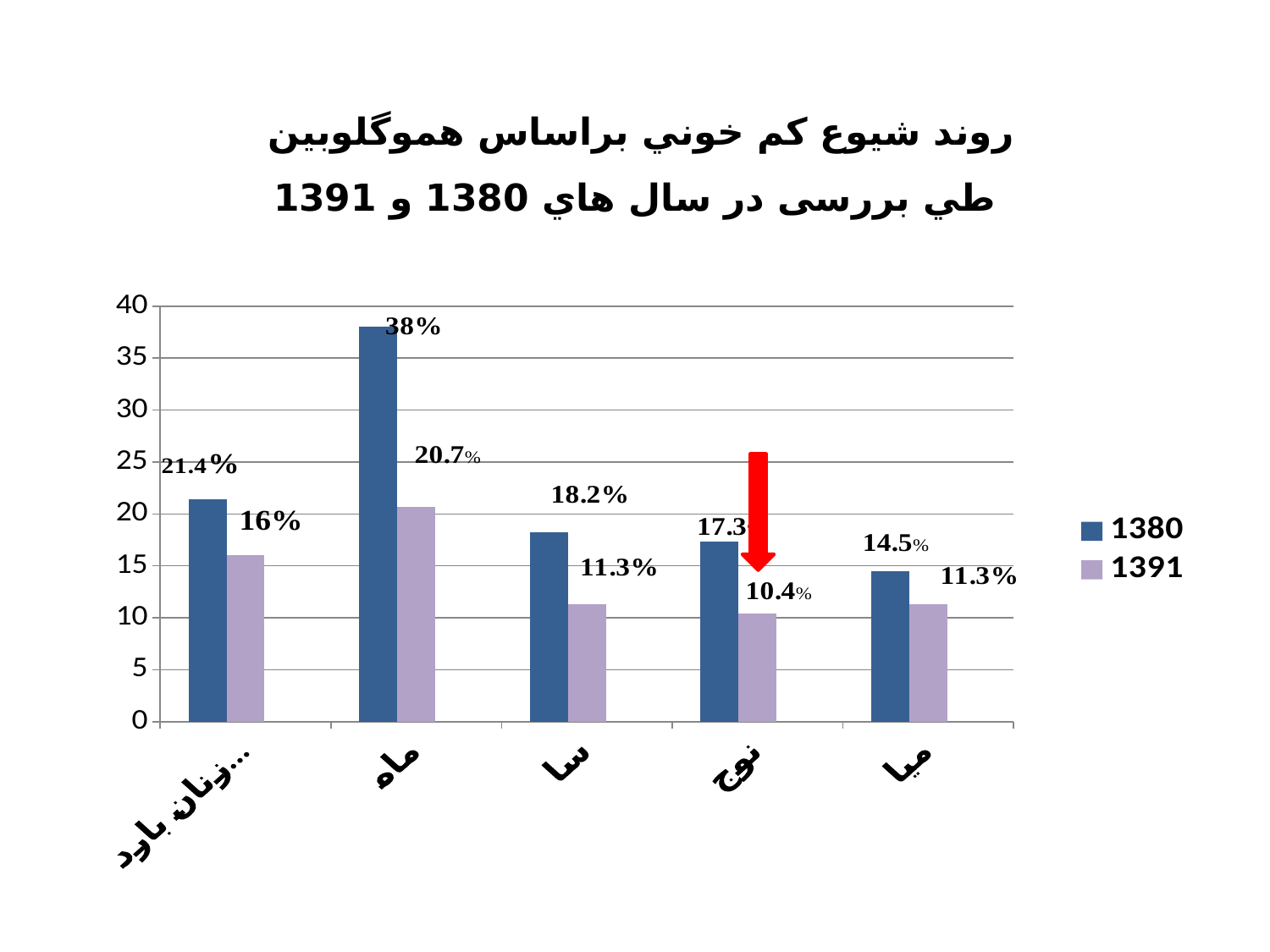
What are the two entries in the legend? 1380 and 1391 How many series does the legend list? 2 What is the 1380 value for the fifth category from the left (میا)? 14.5% What is the difference between the 1380 and 1391 values for the second category (ماه)? 17.3% Which category has the lowest 1391 value? the fourth category (نوج) How many categories are shown along the x axis? 5 What is the 1391 value for the fourth category from the left (نوج)? 10.4% What is the 1380 value for the second category from the left (ماه)? 38% Which category has the highest 1380 value? the second category (ماه) What is the 1391 value for the first category from the left? 16% What kind of chart is shown on the slide? bar chart For the first category, which series has the larger value, 1380 or 1391? 1380